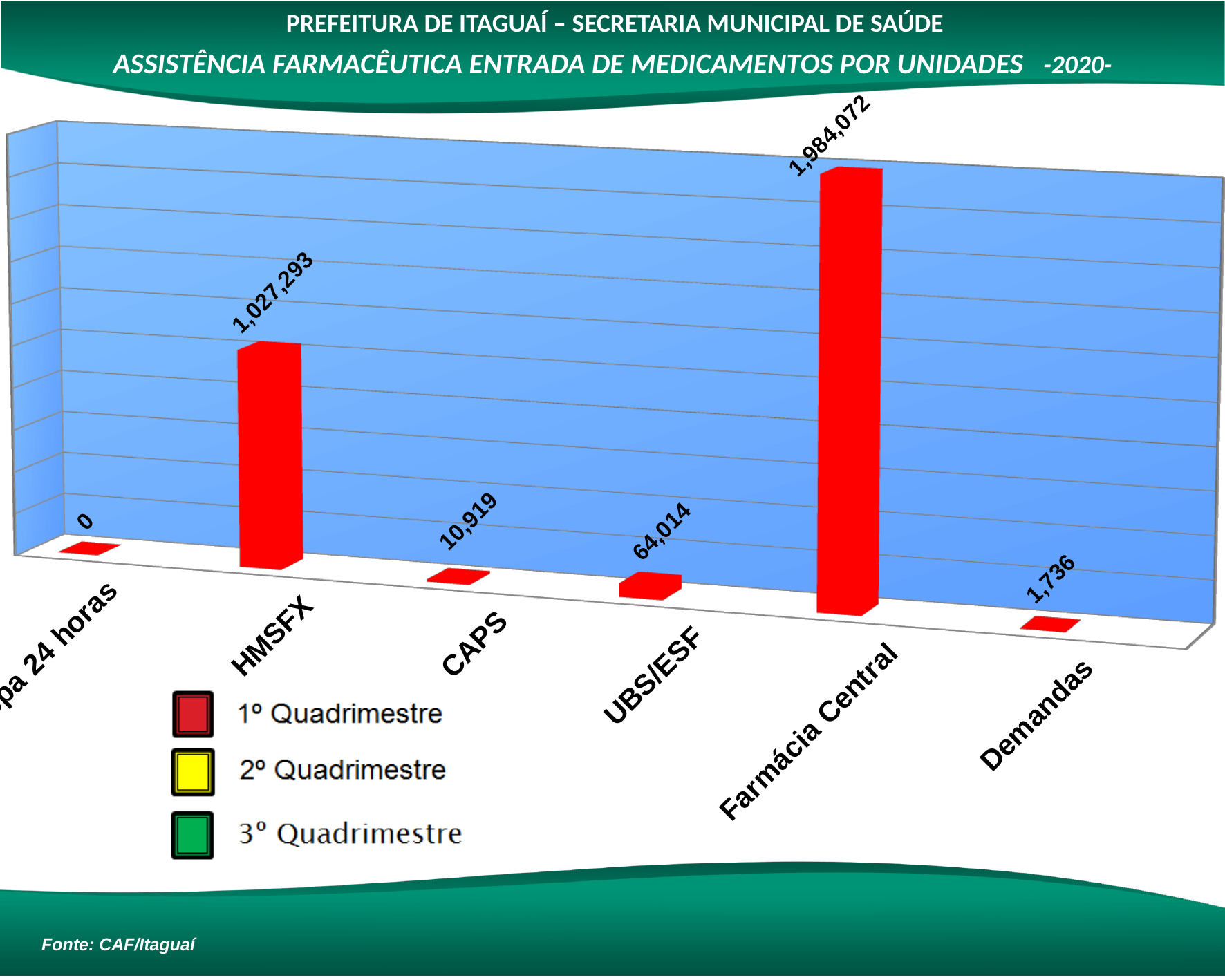
What is the value shown for CAPS? 10,919 What is the value shown for HMSFX? 1,027,293 Which is larger, the value for UBS/ESF or the value for CAPS? UBS/ESF What is the value shown for Farmácia Central? 1,984,072 What is the value shown for Demandas? 1,736 What kind of chart is shown on the slide? bar chart What is the value shown for UBS/ESF? 64,014 How many categories are shown on the x axis? 6 What is the difference between the values for Farmácia Central and HMSFX? 956,779 Which category has the highest value? Farmácia Central What is the difference between the values for UBS/ESF and CAPS? 53,095 How many series does the legend list? 3